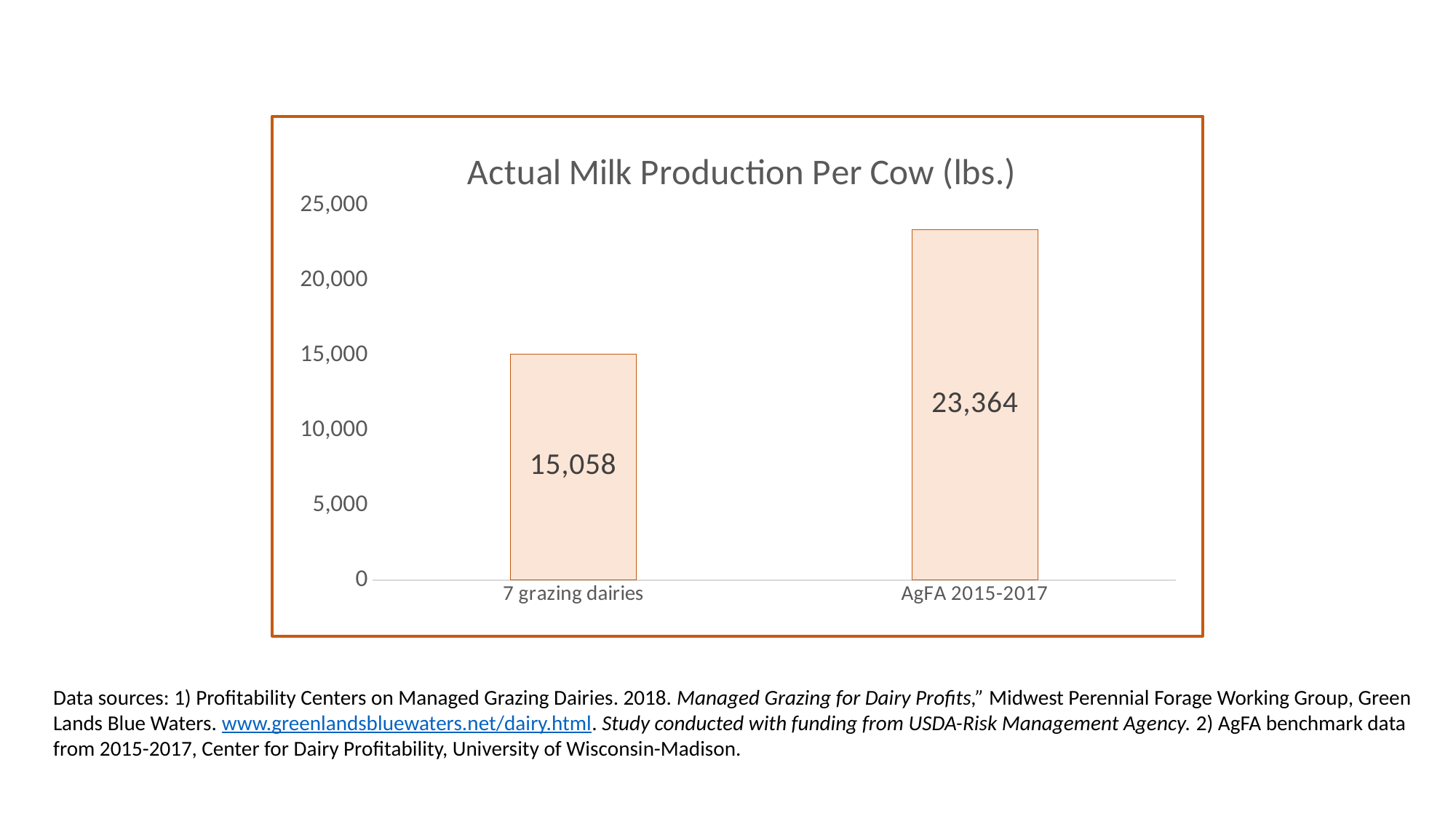
What kind of chart is shown on the slide? bar chart What is the actual milk production per cow for the 7 grazing dairies? 15,058 What is the highest value shown on the vertical axis of the chart? 25,000 Which category has the lowest milk production per cow? 7 grazing dairies What is the difference in milk production per cow between AgFA 2015-2017 and the 7 grazing dairies? 8,306 How many categories are shown in the chart? 2 Which is larger, the milk production per cow for the 7 grazing dairies or for AgFA 2015-2017? AgFA 2015-2017 Which category has the highest milk production per cow? AgFA 2015-2017 Is the value for 7 grazing dairies greater or less than 20,000? less What is the title of the chart? Actual Milk Production Per Cow (lbs.) Is the value for AgFA 2015-2017 greater or less than 20,000? greater What is the actual milk production per cow for AgFA 2015-2017? 23,364